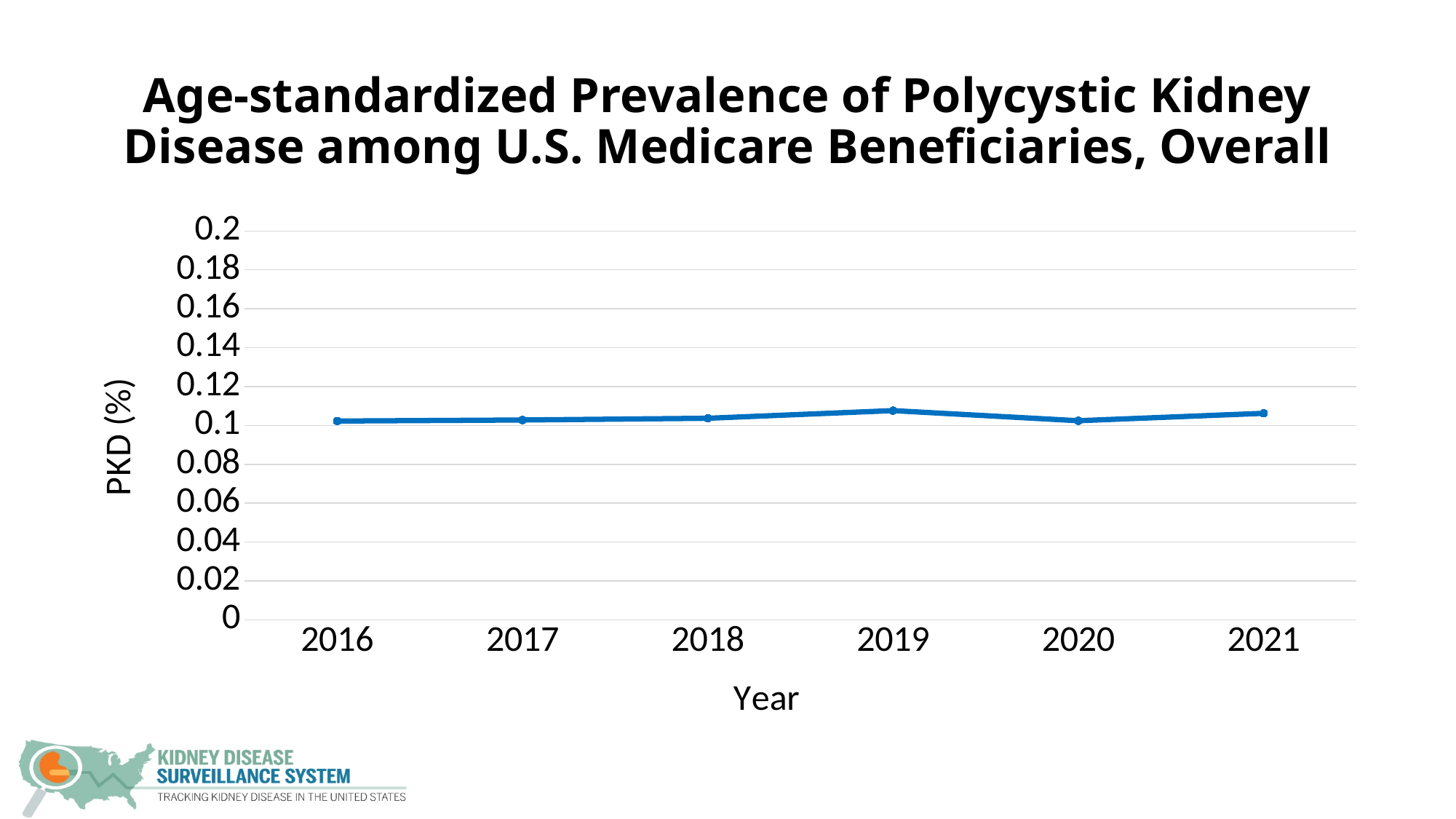
What kind of chart is shown on the slide? line chart Is the value for 2021 greater or less than 0.14? less Which year has the highest PKD prevalence? 2019 What is the label of the y axis? PKD (%) Between 2016 and 2019, does the PKD prevalence rise or fall? rise What is the first year shown on the x axis? 2016 Which is larger, the value for 2019 or the value for 2020? 2019 Is the value for 2019 greater or less than 0.12? less Is the value for 2018 greater or less than 0.08? greater Which is larger, the value for 2021 or the value for 2020? 2021 How many years are plotted on the x axis? 6 What is the label of the x axis? Year